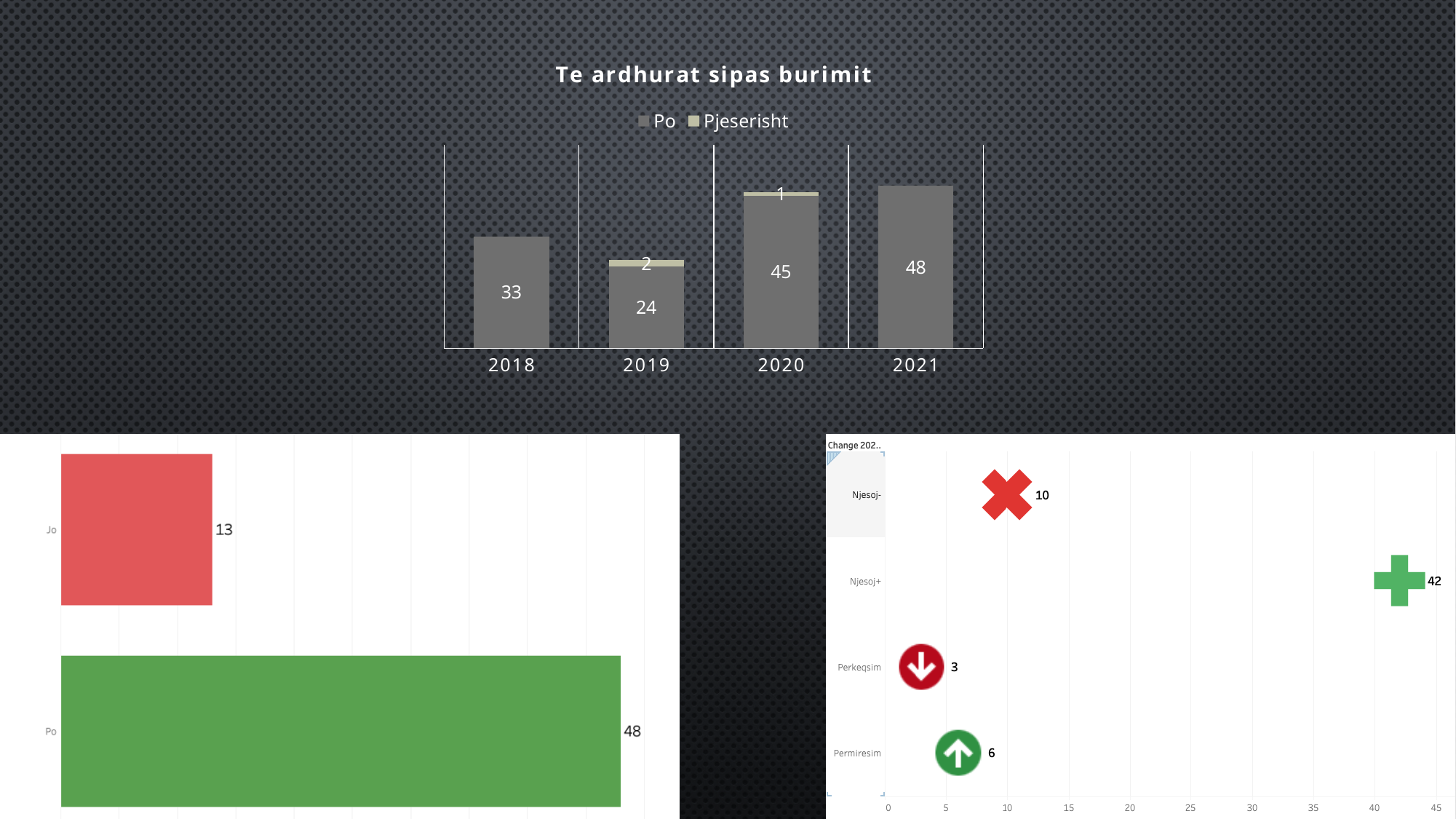
What kind of chart is the bottom-left chart? bar chart In the chart titled "Te ardhurat sipas burimit", what is the value of Pjeserisht for 2019? 2 In the bottom-left chart, which category is larger, Po or Jo? Po In the chart titled "Te ardhurat sipas burimit", what is the total of the stacked bar for 2020? 46 In the bottom-right chart, what is the value for Njesoj+? 42 In the bottom-right chart, which category has the lowest value? Perkeqsim In the chart titled "Te ardhurat sipas burimit", which year has the lowest Po value? 2019 In the chart titled "Te ardhurat sipas burimit", how many series does the legend list? 2 In the bottom-left chart, what is the value for Jo? 13 In the chart titled "Te ardhurat sipas burimit", what is the difference between the Po values for 2021 and 2018? 15 In the chart titled "Te ardhurat sipas burimit", how many years are shown on the x axis? 4 In the chart titled "Te ardhurat sipas burimit", what is the value of Po for 2021? 48